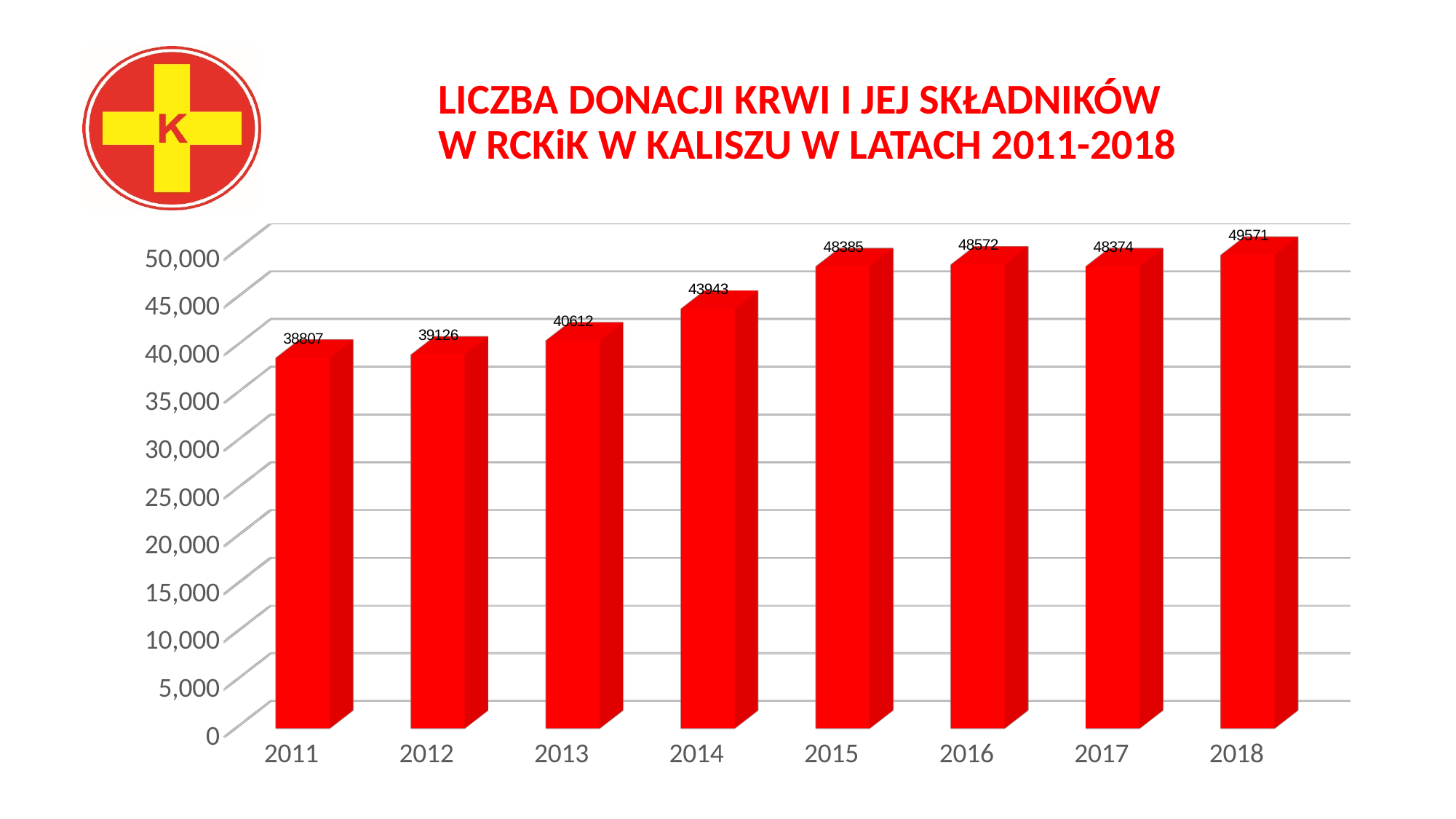
Which year has the highest value? 2018 What kind of chart is shown on the slide? bar chart What is the value for 2014? 43943 What is the value for 2011? 38807 What is the difference between the values for 2018 and 2011? 10764 What is the value for 2018? 49571 Is the value for 2016 greater or less than 45,000? greater Which is larger, the value for 2013 or the value for 2012? 2013 Which year has the lowest value? 2011 Do the values generally rise or fall from 2011 to 2018? rise How many years are shown on the x axis? 8 What is the difference between the values for 2015 and 2014? 4442